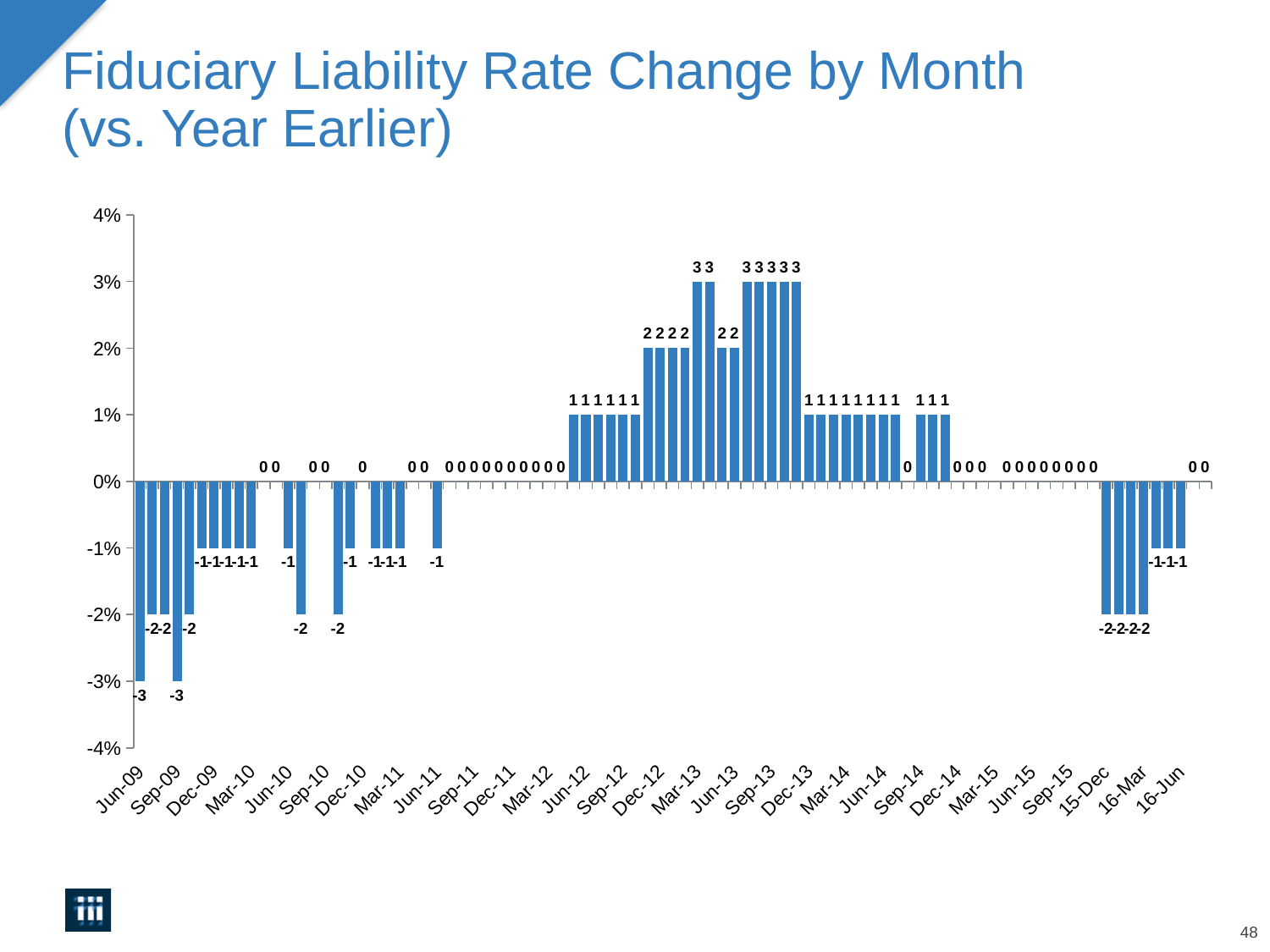
What kind of chart is shown on the slide? bar chart What is the title of the chart? Fiduciary Liability Rate Change by Month (vs. Year Earlier) What is the lowest data label value shown on the chart? -3 What is the difference between the highest labeled value (3) and the lowest labeled value (-3)? 6 What is the rate change value labeled for Jun-09? -3 Do the values generally rise or fall from Jun-09 to Mar-13? rise What is the highest data label value shown on the chart? 3 What are the minimum and maximum values shown on the vertical axis? -4% and 4% Which has the larger value, Jun-09 or 16-Jun? 16-Jun Is the value for Jun-09 greater or less than -2%? less